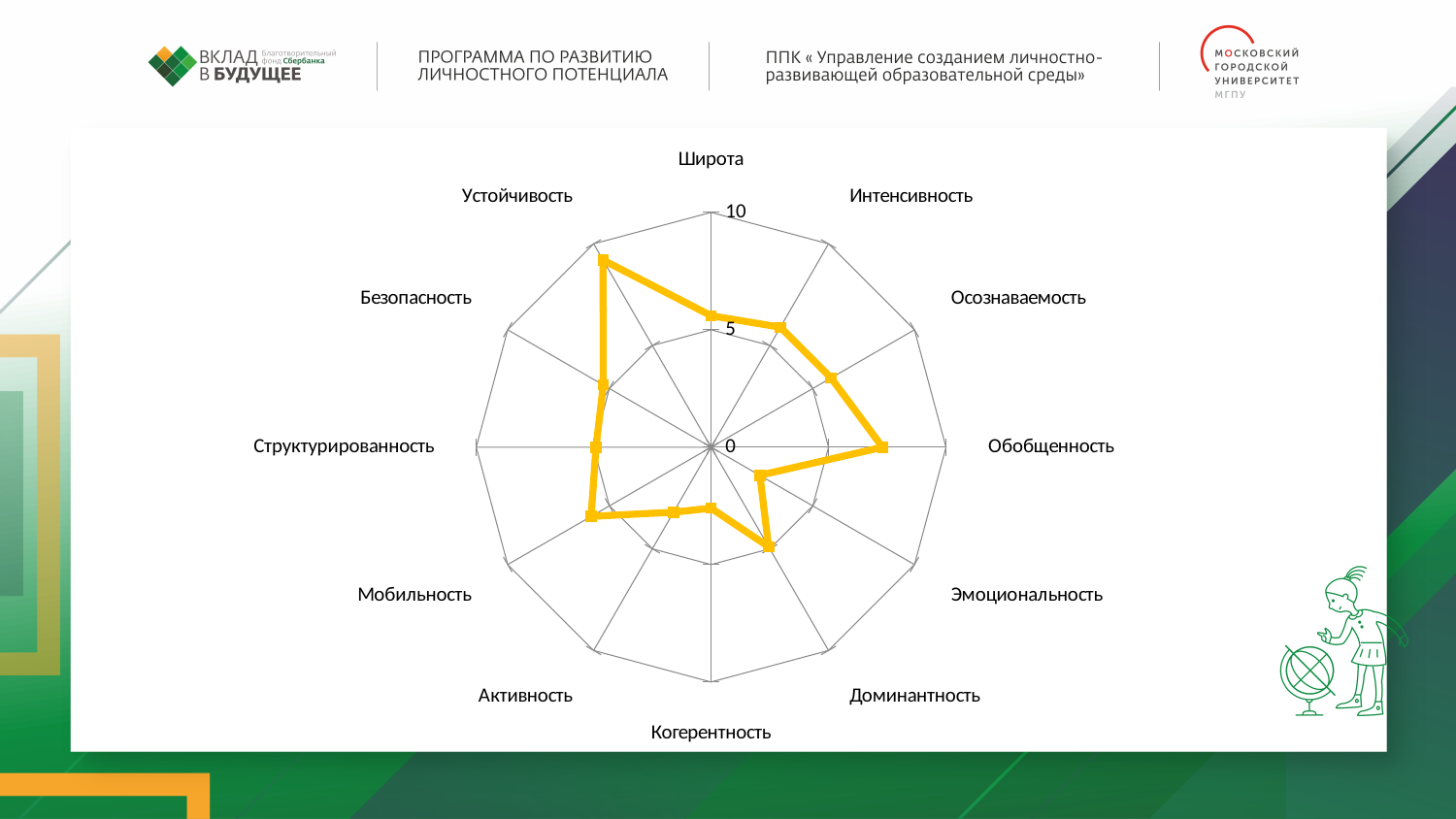
What kind of chart is shown on the slide? Radar chart What colour is the data line on the radar chart? Yellow Which category has the highest value on the radar chart? Устойчивость Is the value for Активность greater or less than 5? less Is the value for Эмоциональность greater or less than 5? less Is the value for Обобщенность greater or less than 5? greater How many categories (axes) does the radar chart have? 12 Which is larger, the value for Обобщенность or the value for Эмоциональность? Обобщенность Which is larger, the value for Устойчивость or the value for Обобщенность? Устойчивость What is the maximum value shown on the radar chart's scale? 10